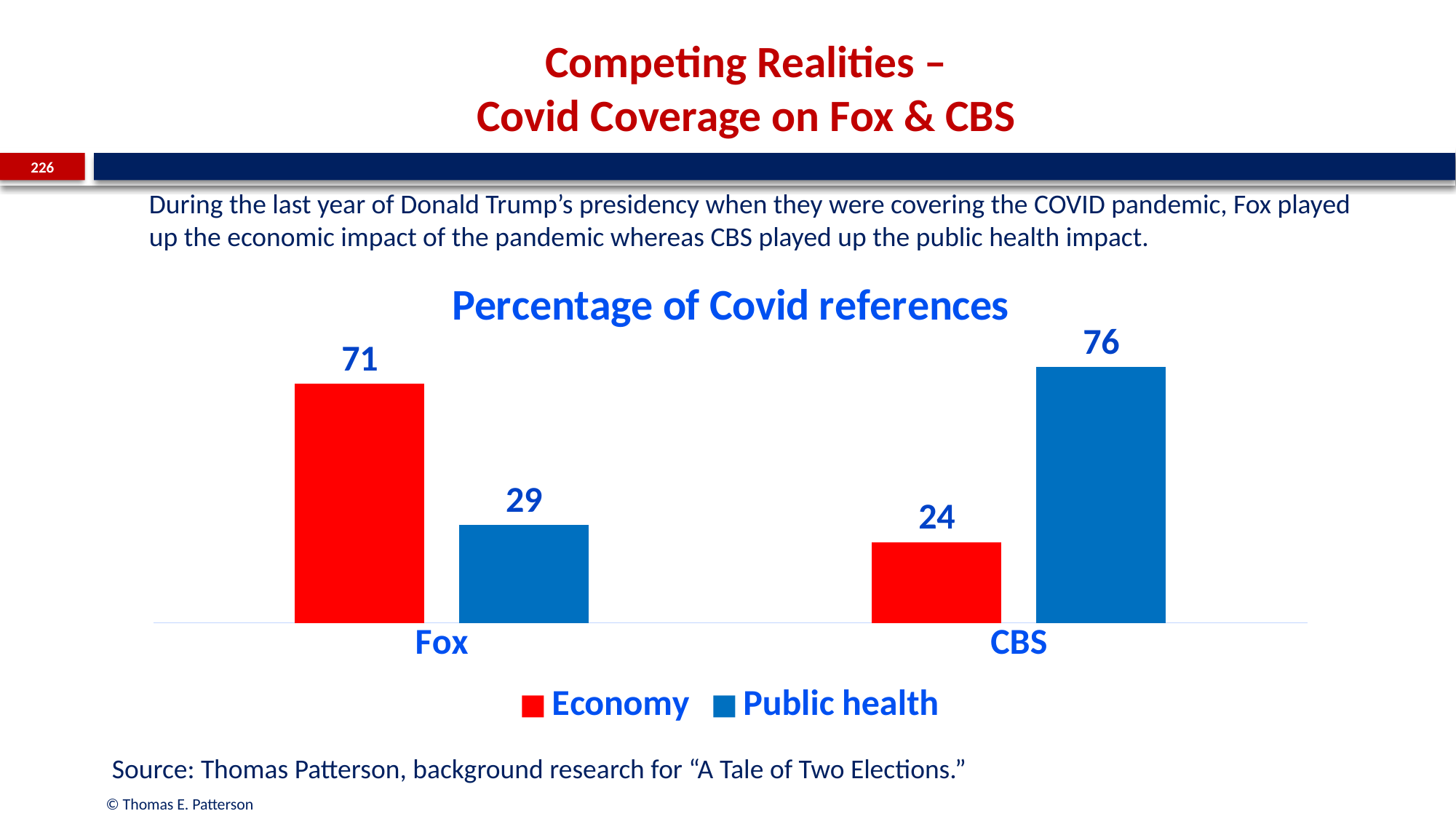
Which network has the lowest Economy value? CBS What is the Economy value for CBS? 24 How many networks are shown on the x axis? 2 How many series does the legend list? 2 Which network has the highest Public health value? CBS Which is larger for CBS, Economy or Public health? Public health What kind of chart is shown? Bar chart What is the Public health value for CBS? 76 What is the title of the chart? Percentage of Covid references What is the difference between the Economy and Public health values for Fox? 42 What is the Economy value for Fox? 71 What is the Public health value for Fox? 29